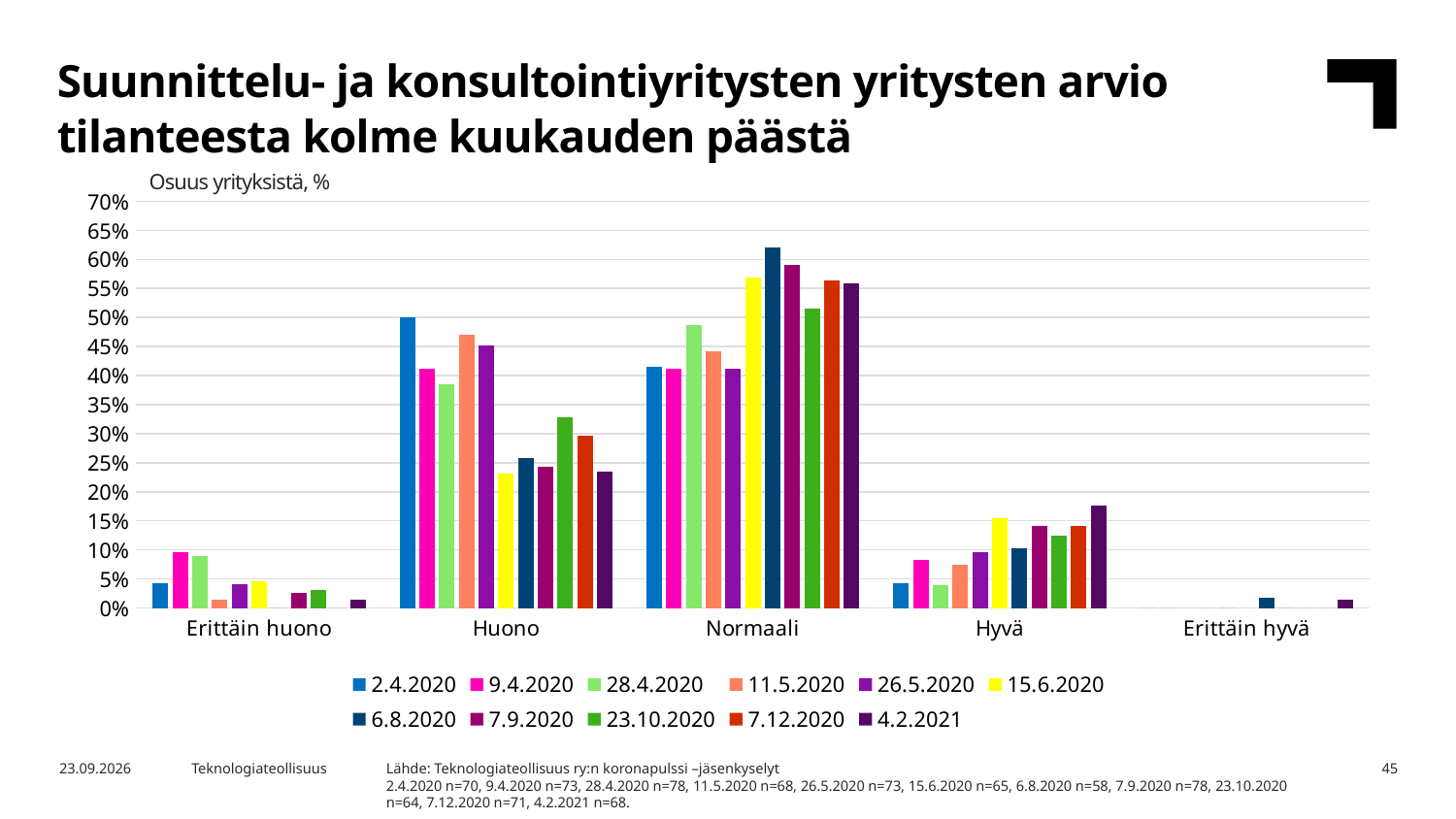
How many categories are shown on the x axis of the chart? 5 In the Huono category, which is larger: the value for 15.6.2020 or the value for 23.10.2020? 23.10.2020 Is the value for 6.8.2020 in the Normaali category greater or less than 60%? greater In the Huono category, which series has the highest value? 2.4.2020 Is the value for 15.6.2020 in the Huono category greater or less than 25%? less In the Normaali category, which is larger: the value for 28.4.2020 or the value for 11.5.2020? 28.4.2020 In the Hyvä category, which series has the highest value? 4.2.2021 Is the value for 2.4.2020 in the Huono category greater or less than 45%? greater How many series does the legend list? 11 What is the label shown above the vertical axis of the chart? Osuus yrityksistä, % What kind of chart is shown on the slide? Bar chart In the Normaali category, which series has the highest value? 6.8.2020